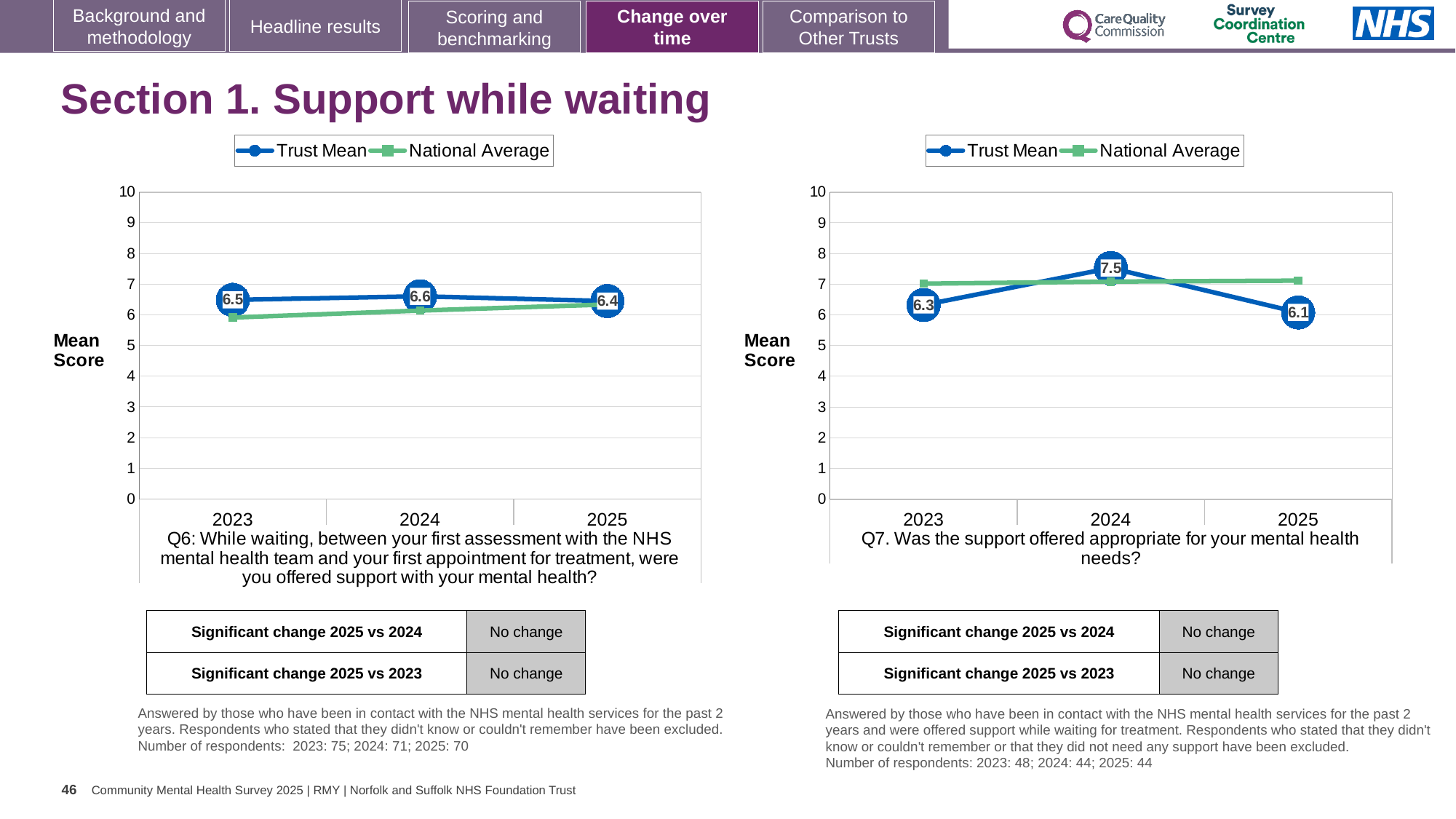
On the Q7 chart (right), is the National Average for 2023 greater or less than 6? greater On the Q7 chart (right), what is the difference between the Trust Mean scores for 2024 and 2025? 1.4 On the Q6 chart (left), what is the Trust Mean score for 2024? 6.6 What kind of chart is the Q6 chart (left)? Line chart On the Q7 chart (right), which year has the highest Trust Mean score? 2024 On the Q7 chart (right), does the Trust Mean rise or fall from 2024 to 2025? Fall How many series does the legend of the Q7 chart (right) list? 2 On the Q7 chart (right), in 2024 which is larger, the Trust Mean or the National Average? Trust Mean How many years are plotted on the Q6 chart (left)? 3 On the Q6 chart (left), which year has the lowest Trust Mean score? 2025 On the Q7 chart (right), what is the Trust Mean score for 2025? 6.1 On the Q6 chart (left), what is the difference between the Trust Mean scores for 2024 and 2023? 0.1